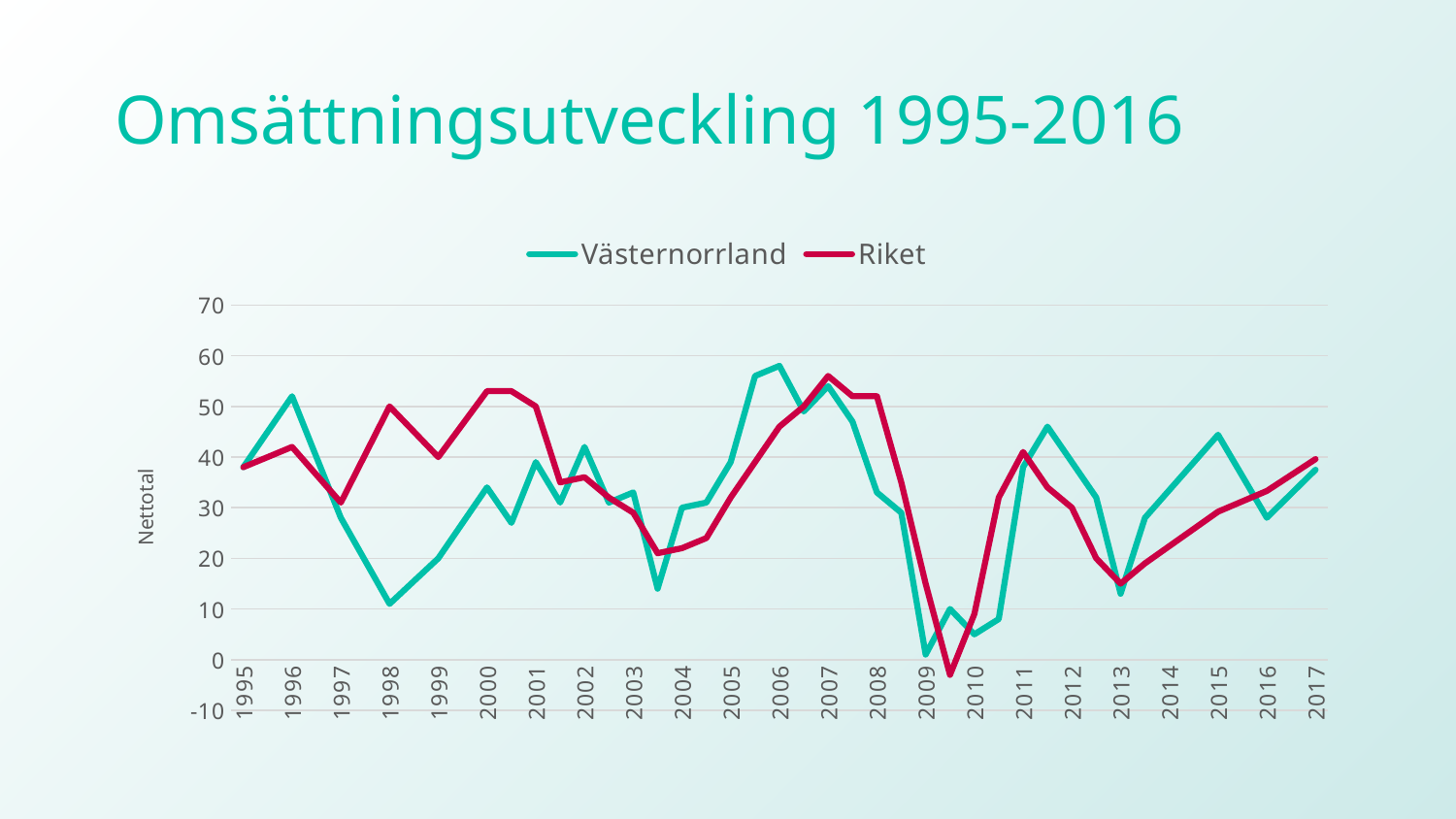
Is the value for Riket at 2000 greater or less than 50? greater What is the title of the chart? Omsättningsutveckling 1995-2016 What is the label on the vertical axis? Nettotal In which year does the Västernorrland series reach its lowest point? 2009 At 2006, which series has the larger value, Västernorrland or Riket? Västernorrland Does the Västernorrland series rise or fall between 1996 and 1998? fall What kind of chart is shown on the slide? line chart How many series does the legend list? 2 Is the value for Riket at 2013 greater or less than 20? less Is the value for Västernorrland at 2006 greater or less than 50? greater At 1998, which series has the larger value, Västernorrland or Riket? Riket